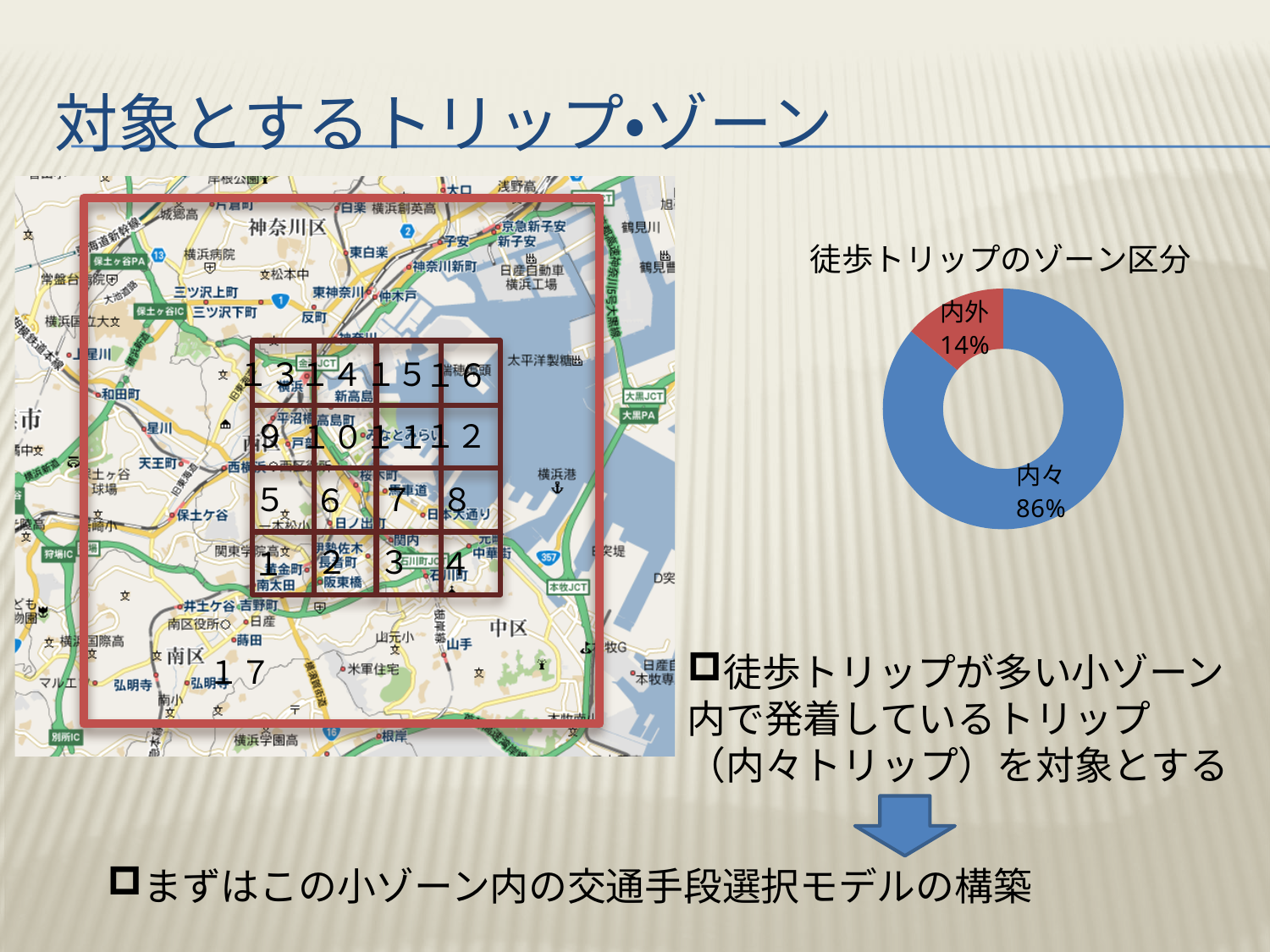
Which category has the largest share in the chart? 内々 Which is larger, the share for 内々 or the share for 内外? 内々 Which category has the smallest share in the chart? 内外 What kind of chart is shown on the slide? doughnut chart How many categories are shown in the chart? 2 What colour is the 内外 segment of the chart? red What share of the chart does 内々 account for? 86% What is the title of the chart on the slide? 徒歩トリップのゾーン区分 What is the difference in percentage points between 内々 and 内外? 72 Is the share for 内々 greater or less than 50%? greater What share of the chart does 内外 account for? 14%